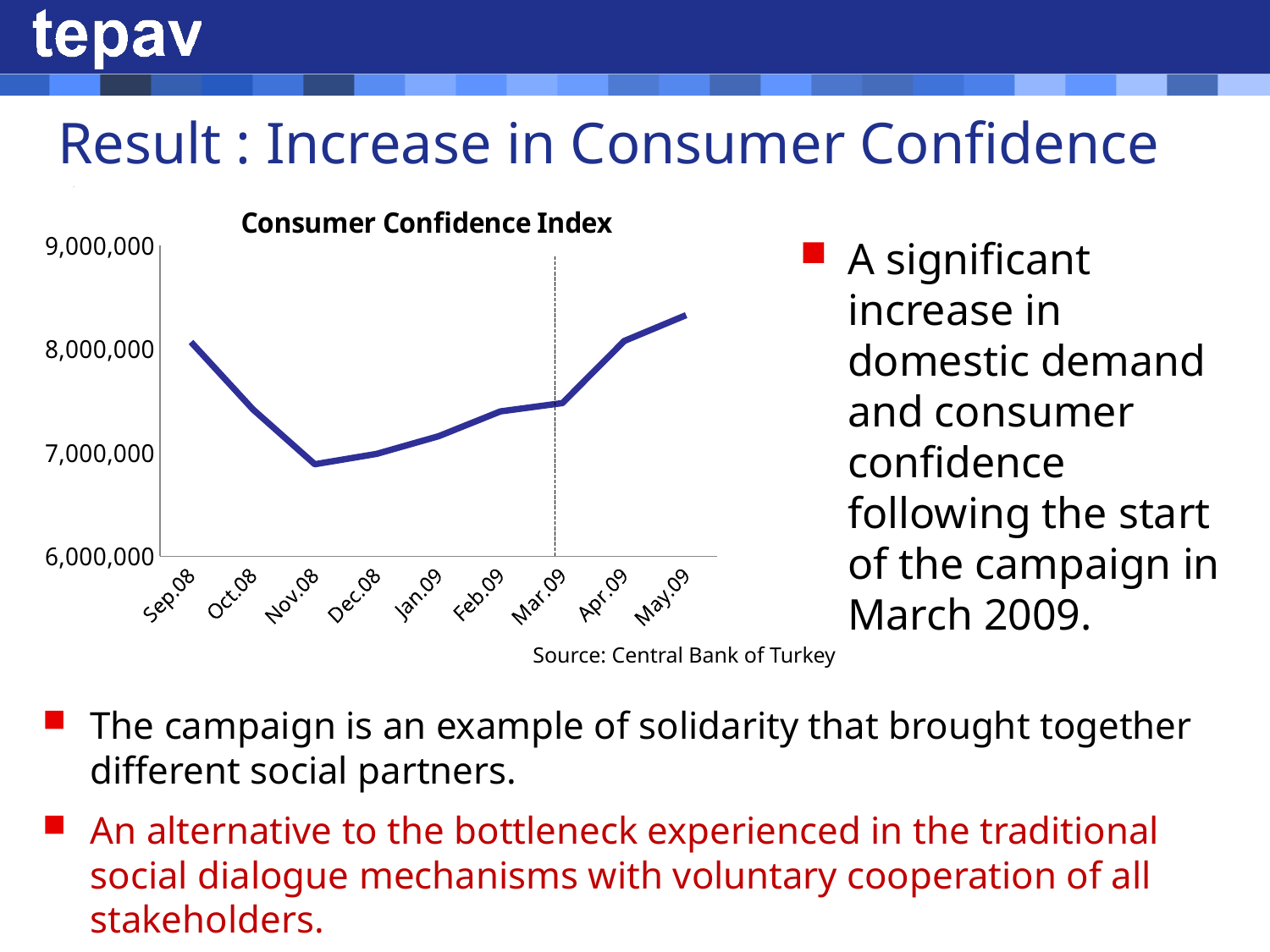
Is the value for Mar.09 greater or less than 8,000,000? less Is the value for Oct.08 greater or less than 7,000,000? greater In which month is the Consumer Confidence Index highest? May.09 What is the title of the chart? Consumer Confidence Index How many months are plotted on the x axis of the chart? 9 Is the value for Nov.08 greater or less than 7,000,000? less In which month is the Consumer Confidence Index lowest? Nov.08 Which is higher, the value for Sep.08 or the value for Nov.08? Sep.08 Does the Consumer Confidence Index rise or fall from Nov.08 to May.09? Rise What source is cited below the chart? Central Bank of Turkey What kind of chart is shown on the slide? Line chart